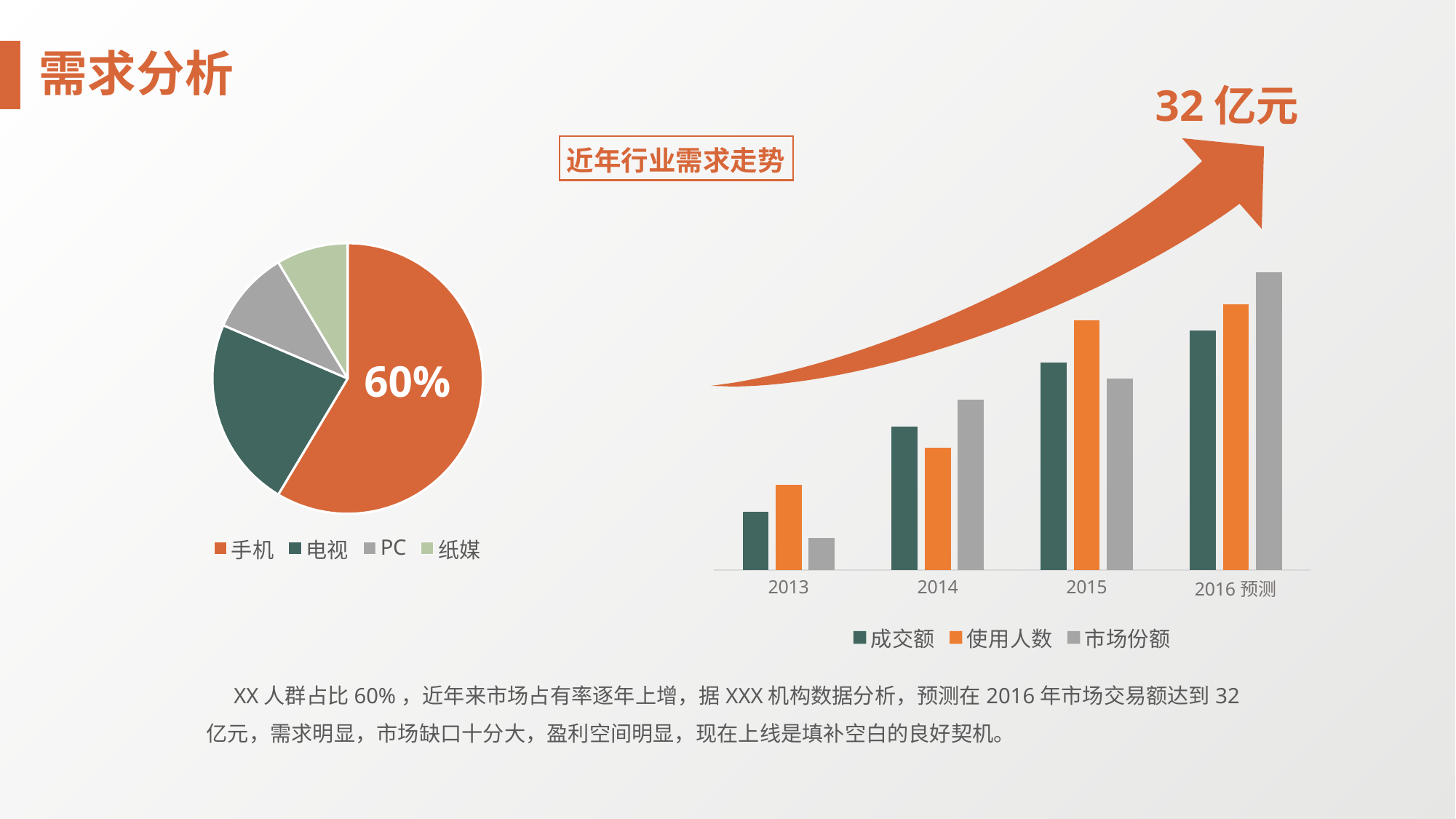
How many slices does the pie chart on the left have? 4 What kind of chart is the chart titled 近年行业需求走势? bar chart In the chart titled 近年行业需求走势, which category has the highest 市场份额 bar? 2016 预测 In the chart titled 近年行业需求走势, for 2013, which is larger: 成交额 or 使用人数? 使用人数 In the chart titled 近年行业需求走势, which category has the lowest 使用人数 bar? 2013 How many categories are shown on the x axis of the chart titled 近年行业需求走势? 4 How many entries does the legend of the pie chart on the left list? 4 In the chart titled 近年行业需求走势, do the values for 成交额 rise or fall from 2013 to 2016 预测? rise On the pie chart on the left, which category has the largest slice? 手机 How many series does the legend of the chart titled 近年行业需求走势 list? 3 On the pie chart on the left, what share does 手机 have? 60% What kind of chart is the chart on the left of the slide? pie chart